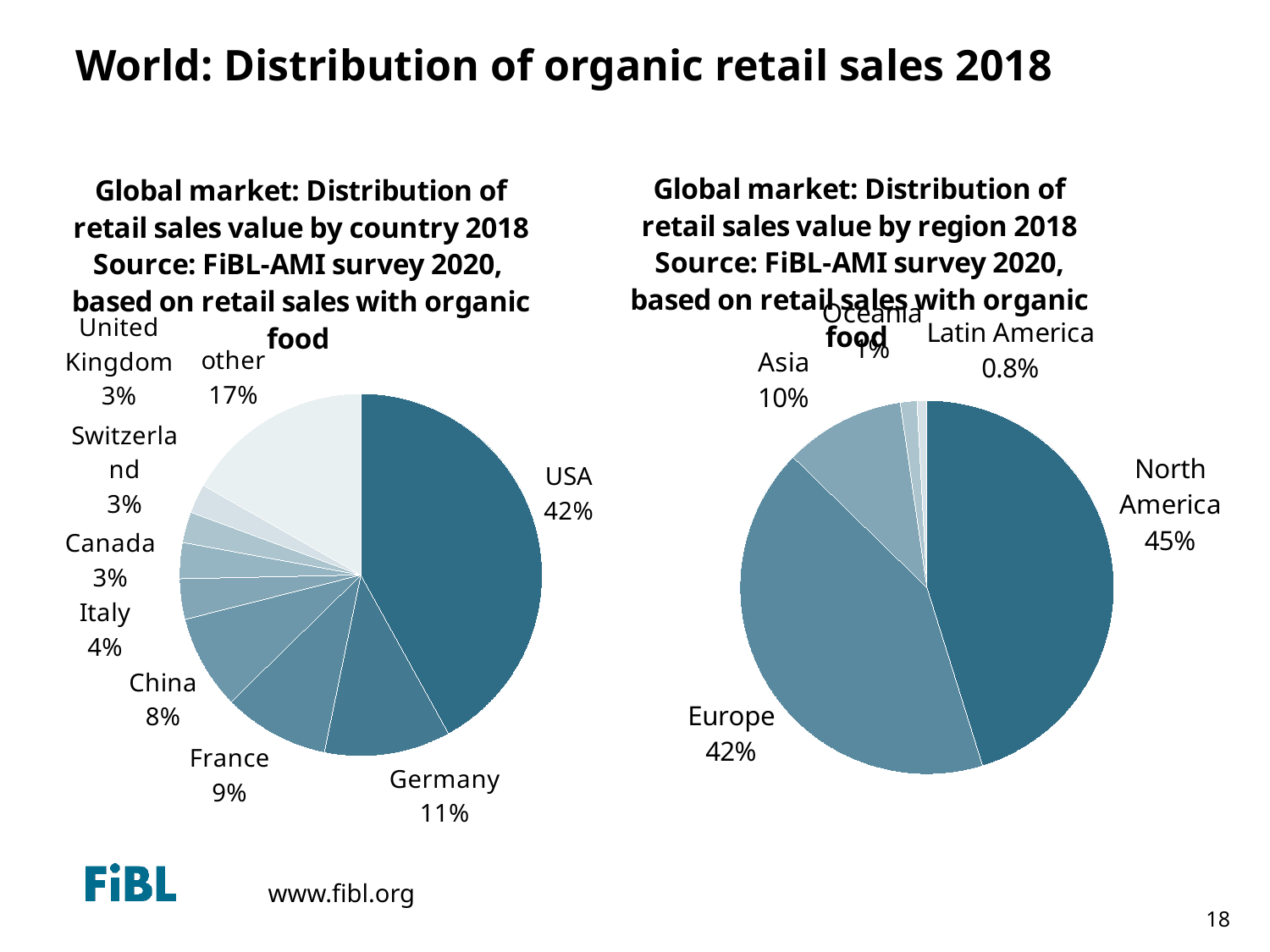
In the left pie chart (distribution by country), what is the difference in percentage points between France and China? 1 percentage point In the right pie chart (distribution by region), what is the share for Asia? 10% In the left pie chart (distribution by country), what share of organic retail sales does the USA account for? 42% In the right pie chart (distribution by region), what share does North America account for? 45% In the right pie chart (distribution by region), which is larger, the share for North America or the share for Europe? North America In the right pie chart (distribution by region), how many regions are shown? 5 In the left pie chart (distribution by country), how many slices does the pie have? 9 What type of chart is used for the distribution by region on the right? Pie chart In the left pie chart (distribution by country), which country has the largest share? USA In the left pie chart (distribution by country), what is the share for Germany? 11% In the right pie chart (distribution by region), which region has the smallest share? Latin America In the left pie chart (distribution by country), what share is labelled 'other'? 17%